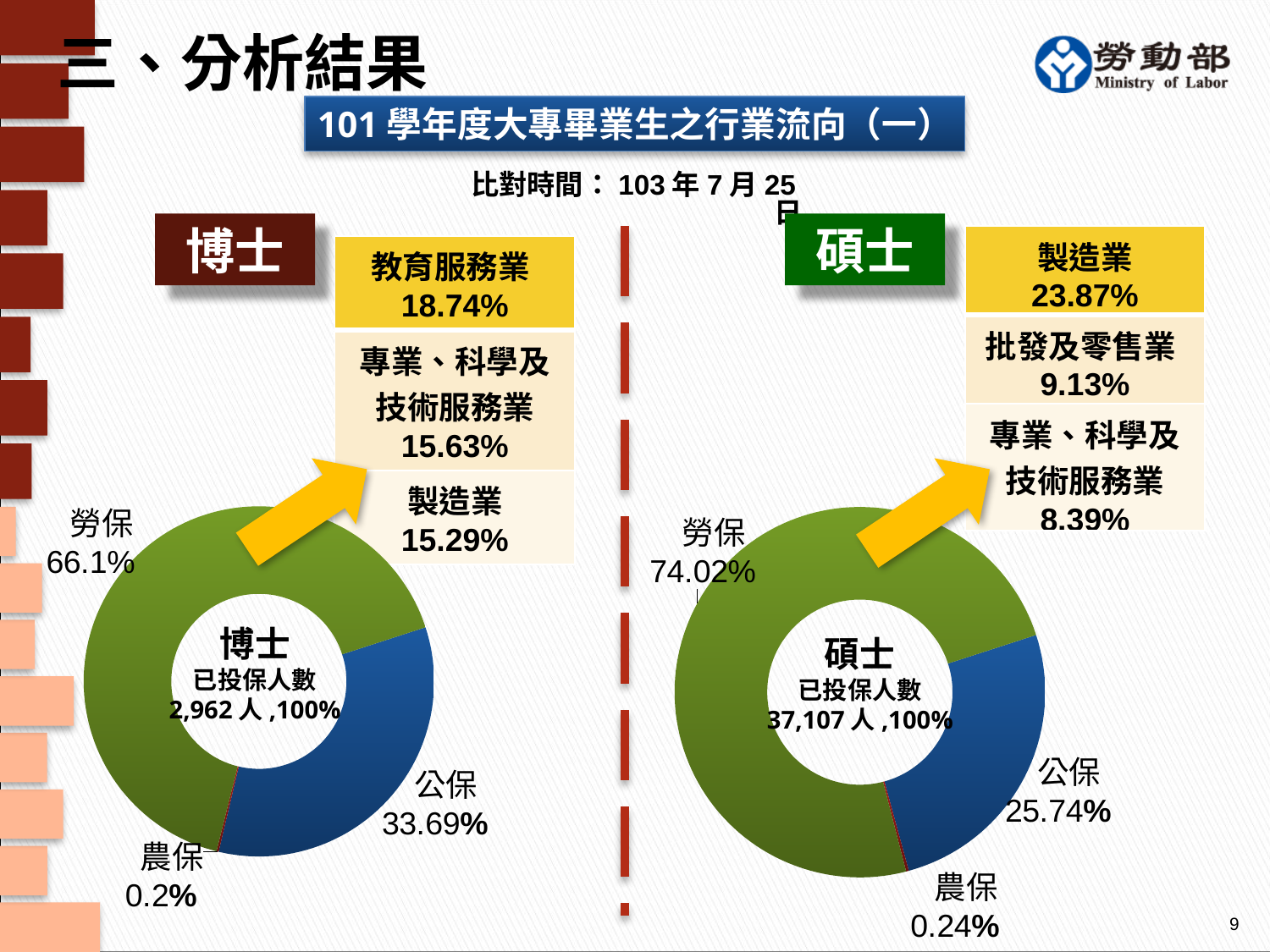
In the 碩士 chart on the right, which category has the smallest share? 農保 What is the total number of insured persons (已投保人數) shown in the centre of the 博士 chart on the left? 2,962 人 How many categories are shown in the 碩士 chart on the right? 3 In the 博士 chart on the left, which category has the largest share? 勞保 In the 博士 chart on the left, what is the value for 公保? 33.69% In the 博士 chart on the left, what is the value for 農保? 0.2% Which is larger: 勞保 in the 博士 chart or 勞保 in the 碩士 chart? 碩士 chart In the 碩士 chart on the right, what is the difference between 勞保 and 公保? 48.28% In the 博士 chart on the left, what is the value for 勞保? 66.1% In the 碩士 chart on the right, what is the value for 勞保? 74.02% In the 碩士 chart on the right, what is the value for 公保? 25.74% What type of chart is used for the 博士 chart on the left? doughnut chart